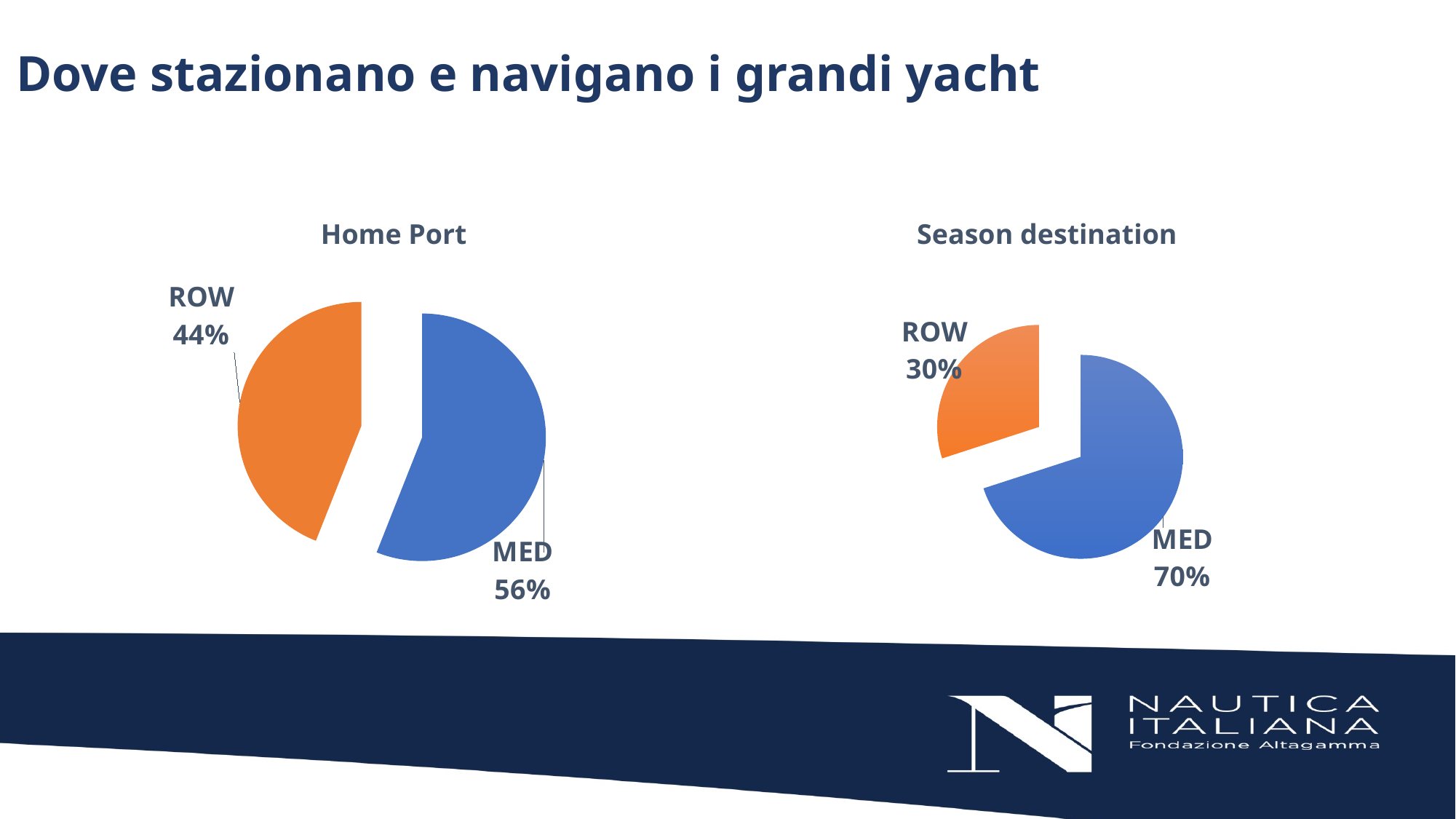
What colour is the ROW slice in the Home Port chart? Orange In the Season destination chart, which slice is the smallest? ROW Is the MED share larger in the Home Port chart or in the Season destination chart? Season destination In the Home Port chart, what is the difference between the MED and ROW shares? 12% In the Home Port chart, which slice is the largest? MED In the Home Port chart, what share does MED have? 56% In the Season destination chart, what share does MED have? 70% What kind of chart is the Season destination chart? Pie chart In the Season destination chart, what is the difference between the MED and ROW shares? 40% How many slices does the Home Port chart have? 2 In the Season destination chart, what share does ROW have? 30% In the Home Port chart, what share does ROW have? 44%